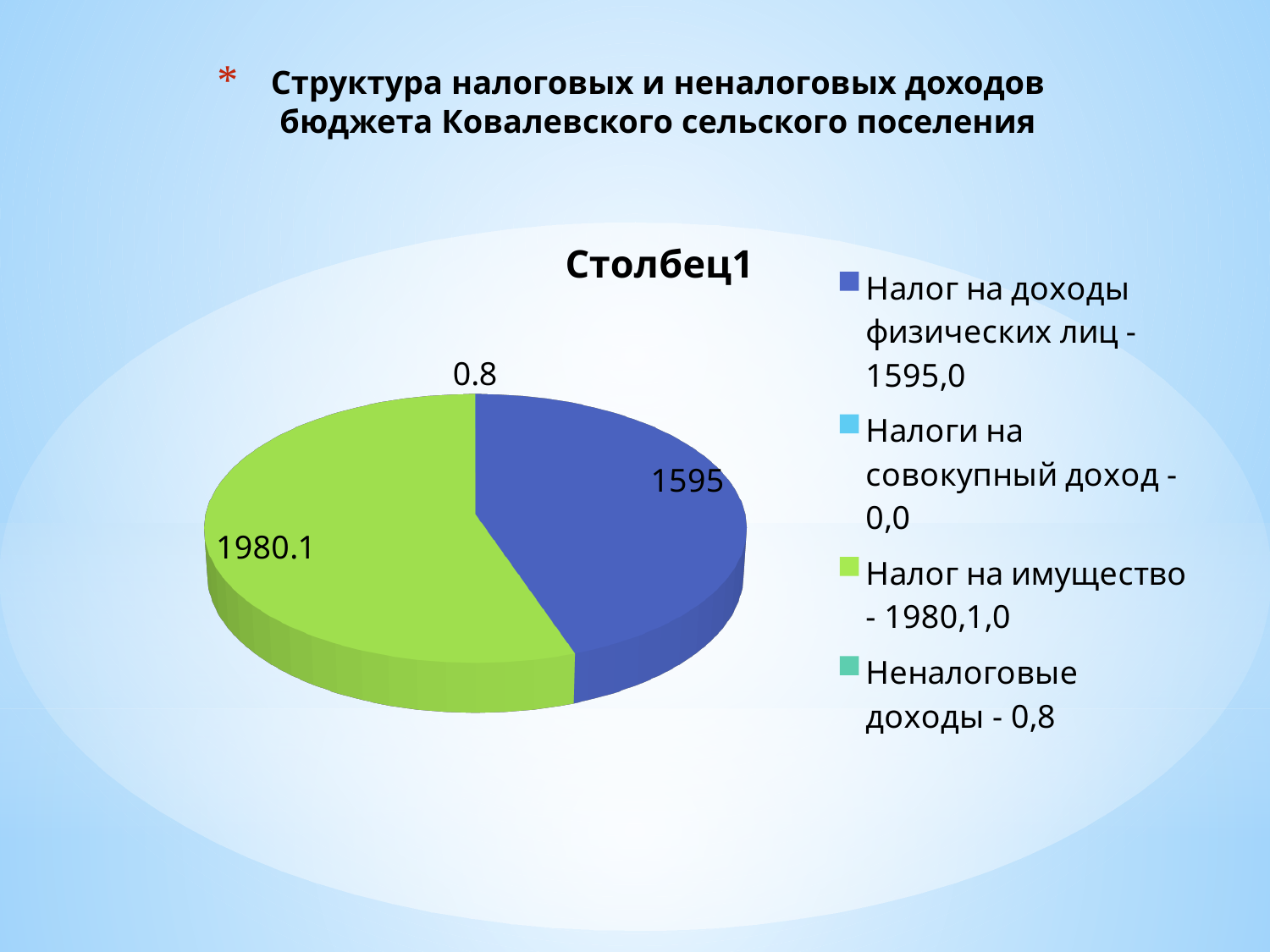
What is the difference between the labelled values for Налог на имущество and Налог на доходы физических лиц? 385.1 What is the title shown above the pie chart? Столбец1 What kind of chart is shown on the slide? Pie chart Which is larger: the value for Налог на доходы физических лиц or the value for Налог на имущество? Налог на имущество What value is labelled on the slice for Неналоговые доходы? 0.8 According to the legend, what is the value for Налоги на совокупный доход? 0,0 What value is labelled on the slice for Налог на имущество? 1980.1 Which category has the smallest value according to the legend? Налоги на совокупный доход Which category has the largest slice of the pie? Налог на имущество What value is labelled on the slice for Налог на доходы физических лиц? 1595 How many entries does the legend list? 4 What colour is the slice for Налог на имущество? Green